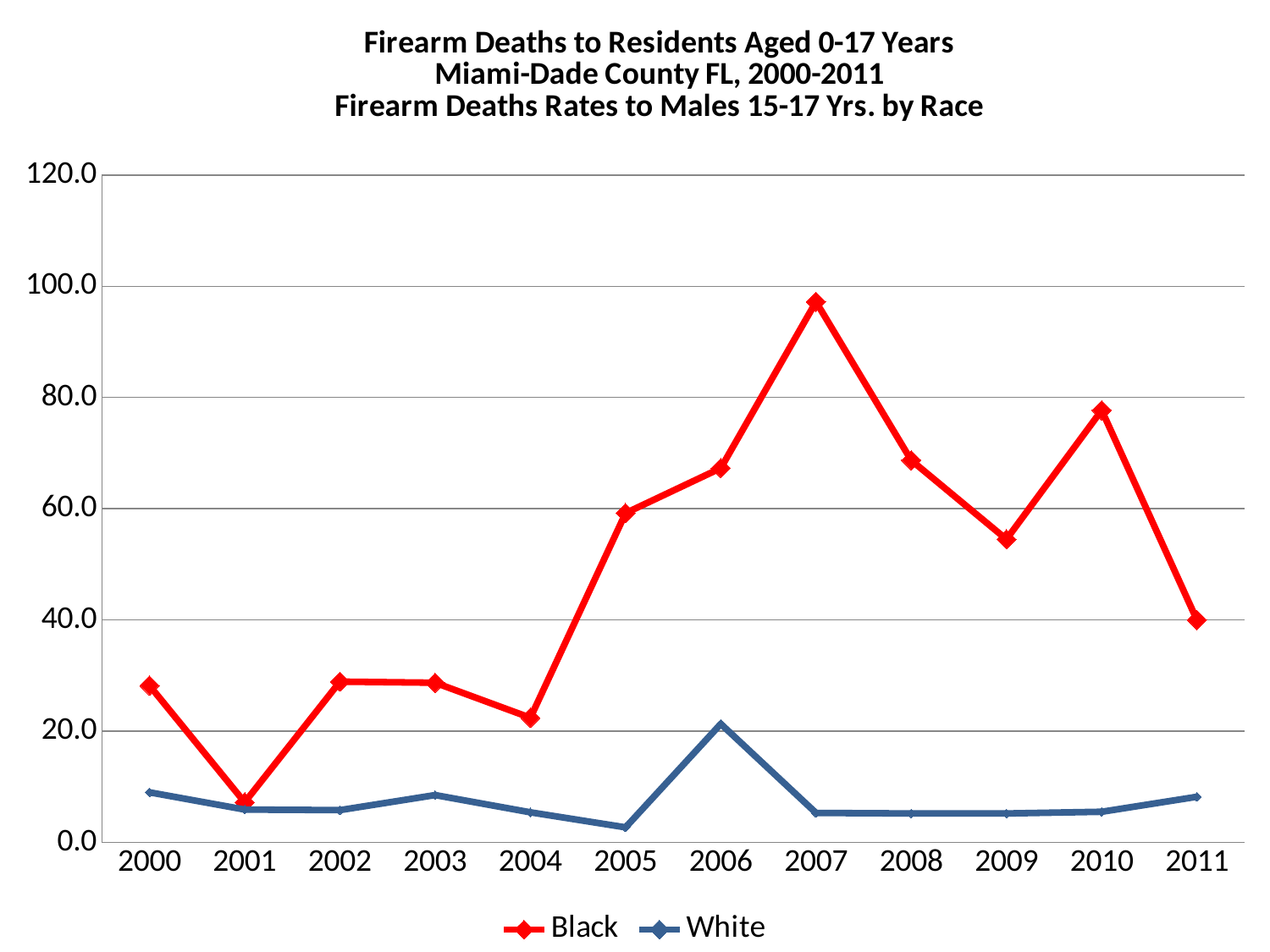
Is the value for Black in 2001 greater or less than 20? less In which year does the Black series reach its lowest value? 2001 Which is larger, the Black value in 2010 or the Black value in 2008? 2010 How many series does the legend list? 2 In which year does the White series reach its highest value? 2006 Is the value for Black in 2007 greater or less than 80? greater What kind of chart is shown on the slide? line chart Is the value for White in 2006 greater or less than 10? greater Does the Black series rise or fall from 2007 to 2009? fall In which year does the Black series reach its highest value? 2007 How many years are plotted along the x axis? 12 What colour is the line for the White series? blue